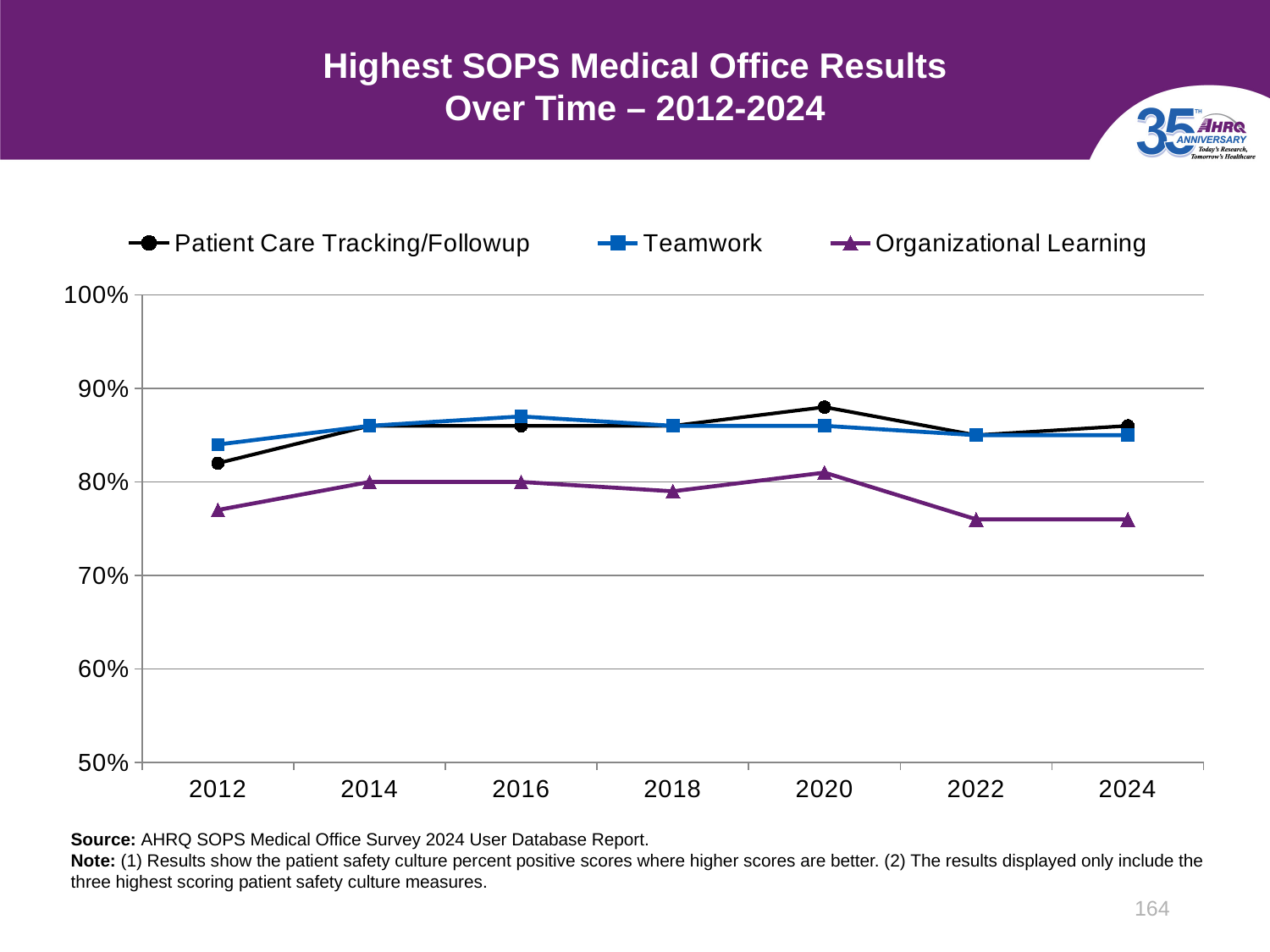
Which series has the lowest value in every year shown? Organizational Learning How many series does the legend list? 3 Which series has the highest value in 2020? Patient Care Tracking/Followup Is the value for Organizational Learning in 2012 greater or less than 80%? less Does the Organizational Learning line rise or fall from 2020 to 2022? fall What kind of chart is shown on the slide? line chart How many years are plotted along the x axis? 7 Is the value for Organizational Learning in 2022 greater or less than 80%? less In 2024, which is larger: Teamwork or Organizational Learning? Teamwork Is the value for Patient Care Tracking/Followup in 2020 greater or less than 90%? less What is the title of the chart? Highest SOPS Medical Office Results Over Time – 2012-2024